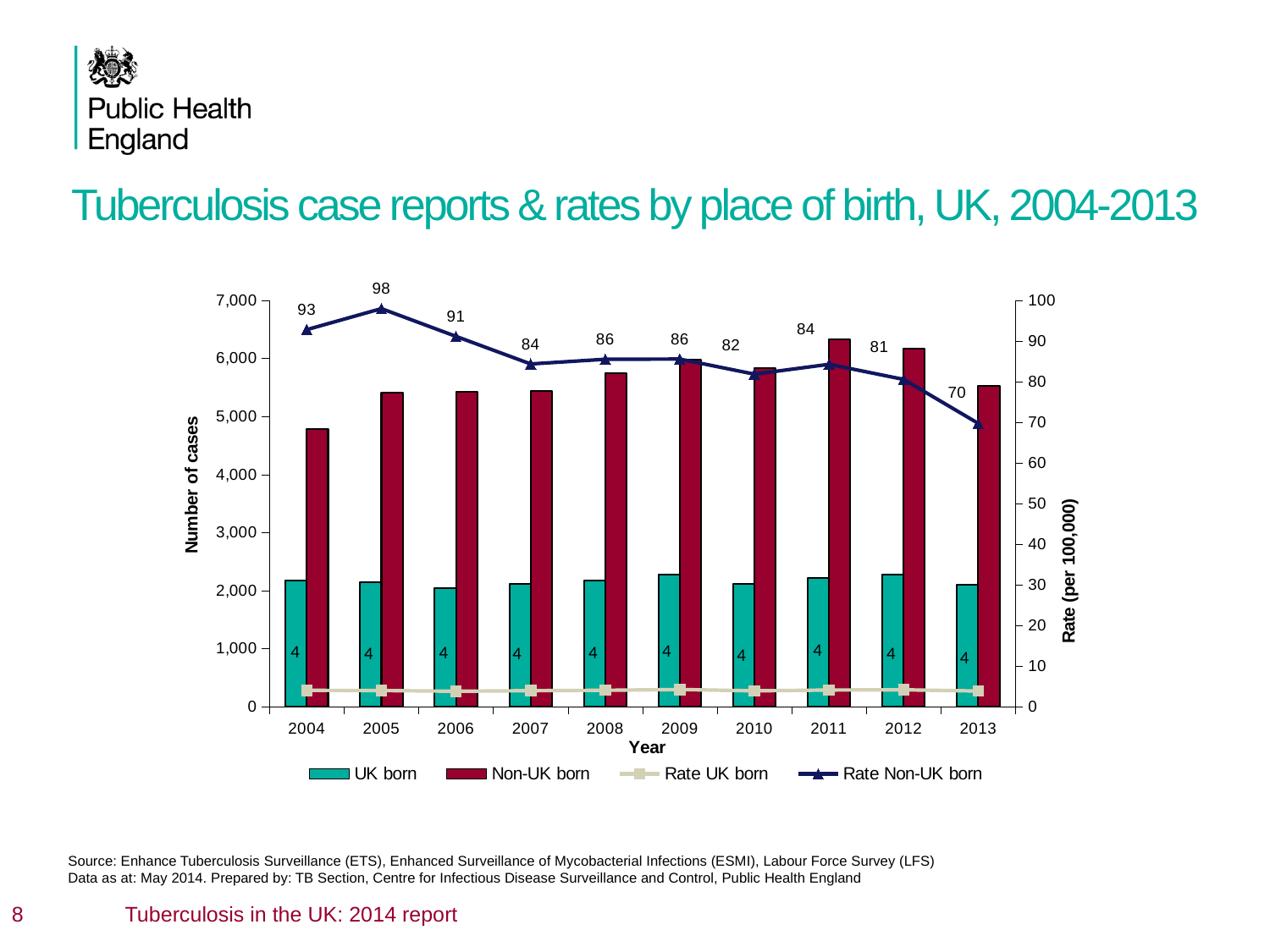
What is the Rate Non-UK born value for 2005? 98 How many years are shown on the x axis? 10 Is the number of Non-UK born cases in 2012 greater or less than 6,000? greater What is the Rate Non-UK born value for 2013? 70 Is the number of Non-UK born cases in 2004 greater or less than 5,000? less In 2008, which is larger: the number of UK born cases or Non-UK born cases? Non-UK born What is the Rate UK born value for 2010? 4 Does the Rate Non-UK born rise or fall from 2005 to 2013? fall How many series does the legend list? 4 What is the difference between the Rate Non-UK born in 2004 and in 2013? 23 In which year is the Rate Non-UK born lowest? 2013 In which year is the Rate Non-UK born highest? 2005